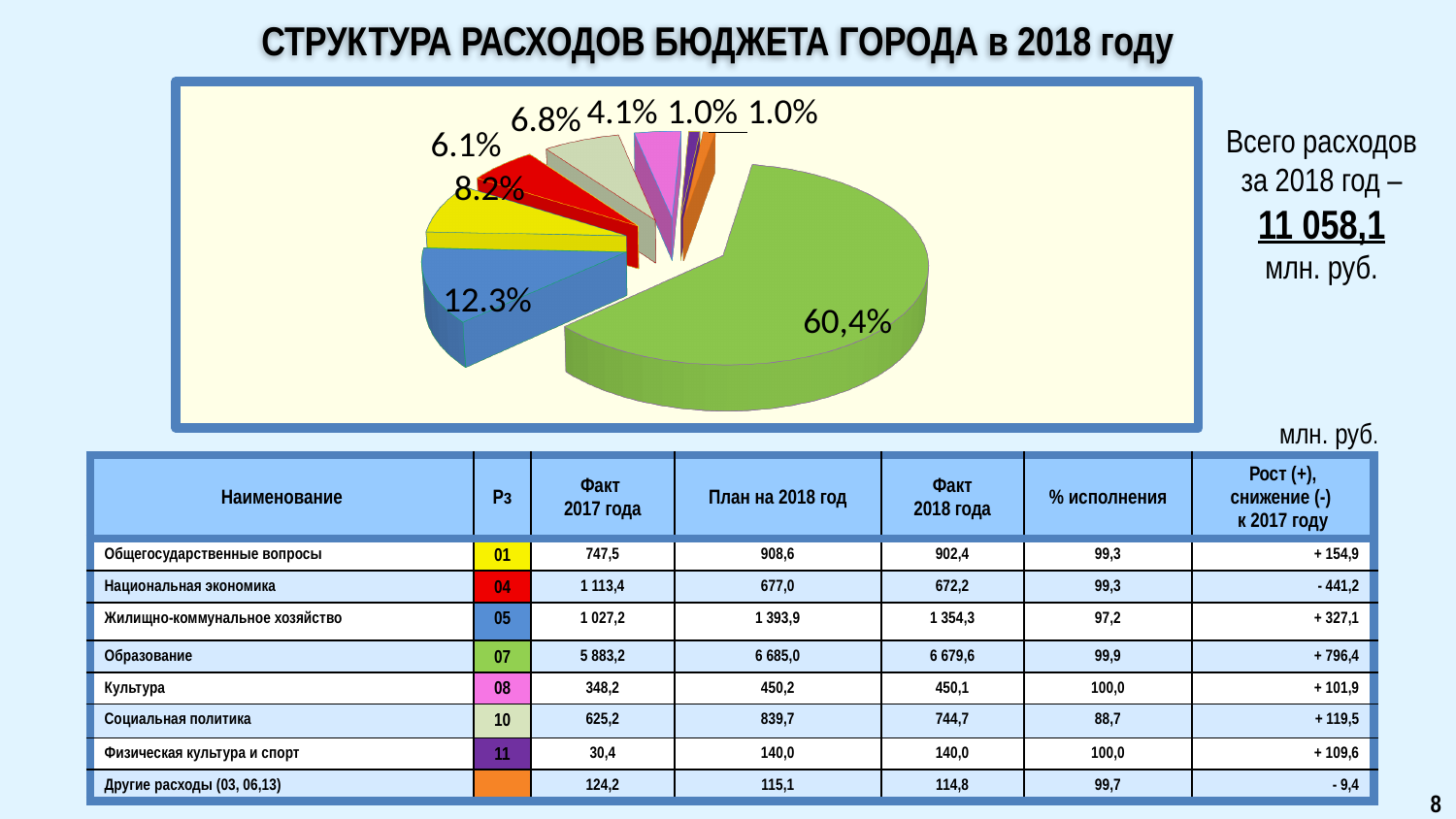
By how many percentage points does the largest slice (60,4%) exceed the blue slice (12.3%)? 48.1 percentage points What share does the yellow slice of the pie chart represent? 8.2% What is the title of the slide containing the pie chart? СТРУКТУРА РАСХОДОВ БЮДЖЕТА ГОРОДА в 2018 году According to the text next to the pie chart, what is the total expenditure for 2018? 11 058,1 млн. руб. What share does the pink slice of the pie chart represent? 4.1% What is the share of the largest slice of the pie chart? 60,4% Which slice of the pie chart is larger, the blue one or the yellow one? the blue one How many slices does the pie chart have? 8 What share does the blue slice of the pie chart represent? 12.3% What is the share of the smallest slices of the pie chart? 1.0% What kind of chart is shown on the slide? pie chart What share does the red slice of the pie chart represent? 6.1%